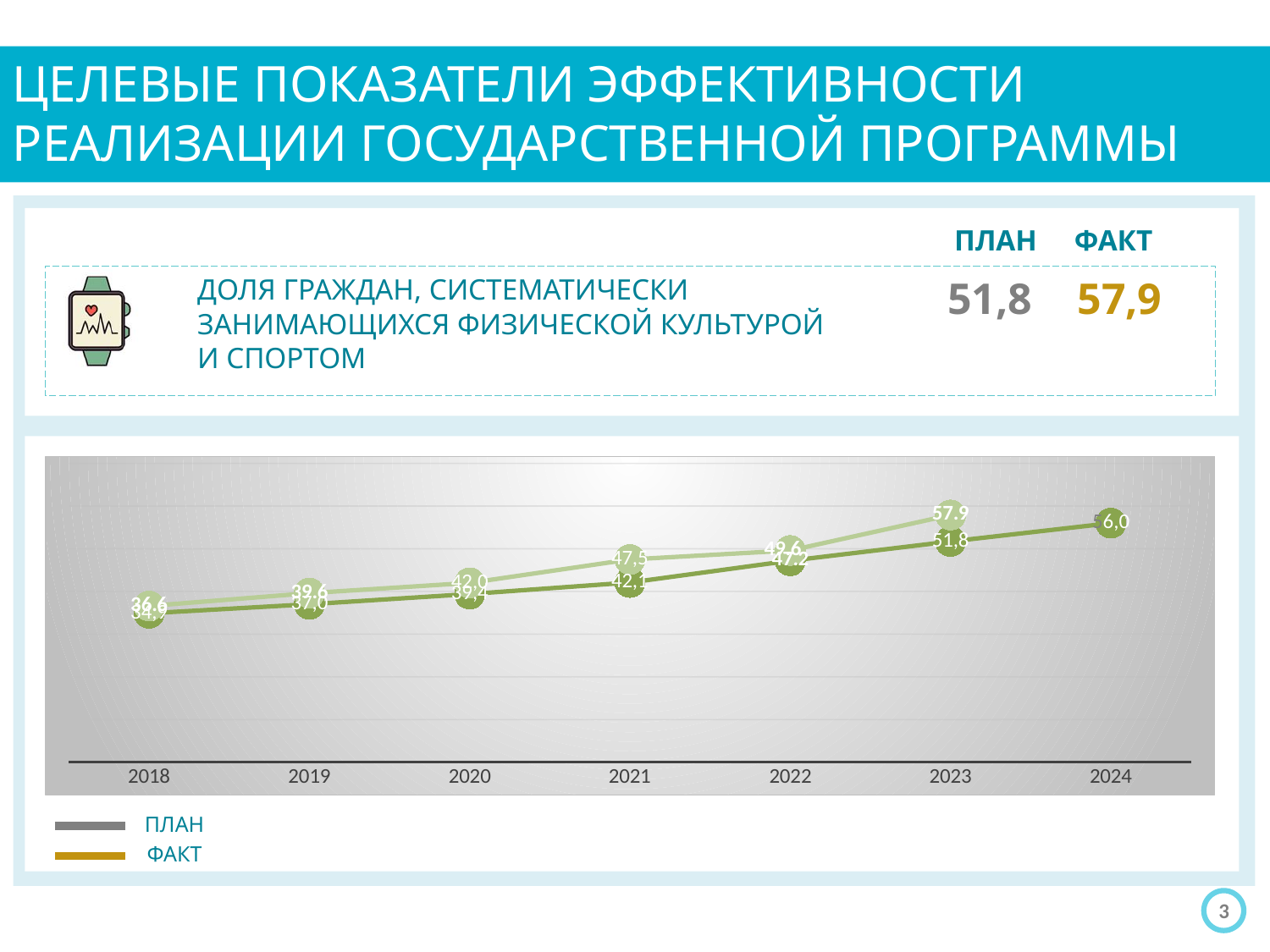
In 2022, which is larger: the ПЛАН value or the ФАКТ value? ФАКТ By how much does the ФАКТ value exceed the ПЛАН value in 2023? 6,1 What kind of chart is shown on the slide? line chart What is the ФАКТ value for 2020 in the chart? 42,0 What is the ФАКТ value for 2022 in the chart? 49,6 What is the ПЛАН value for 2023 in the chart? 51,8 How many series does the chart's legend list? 2 What is the ПЛАН value for 2021 in the chart? 42,1 What are the two entries in the chart's legend? ПЛАН and ФАКТ How many years are shown along the x axis of the chart? 7 What is the ФАКТ value for 2023 in the chart? 57,9 Do the ПЛАН values rise or fall from 2018 to 2024? rise